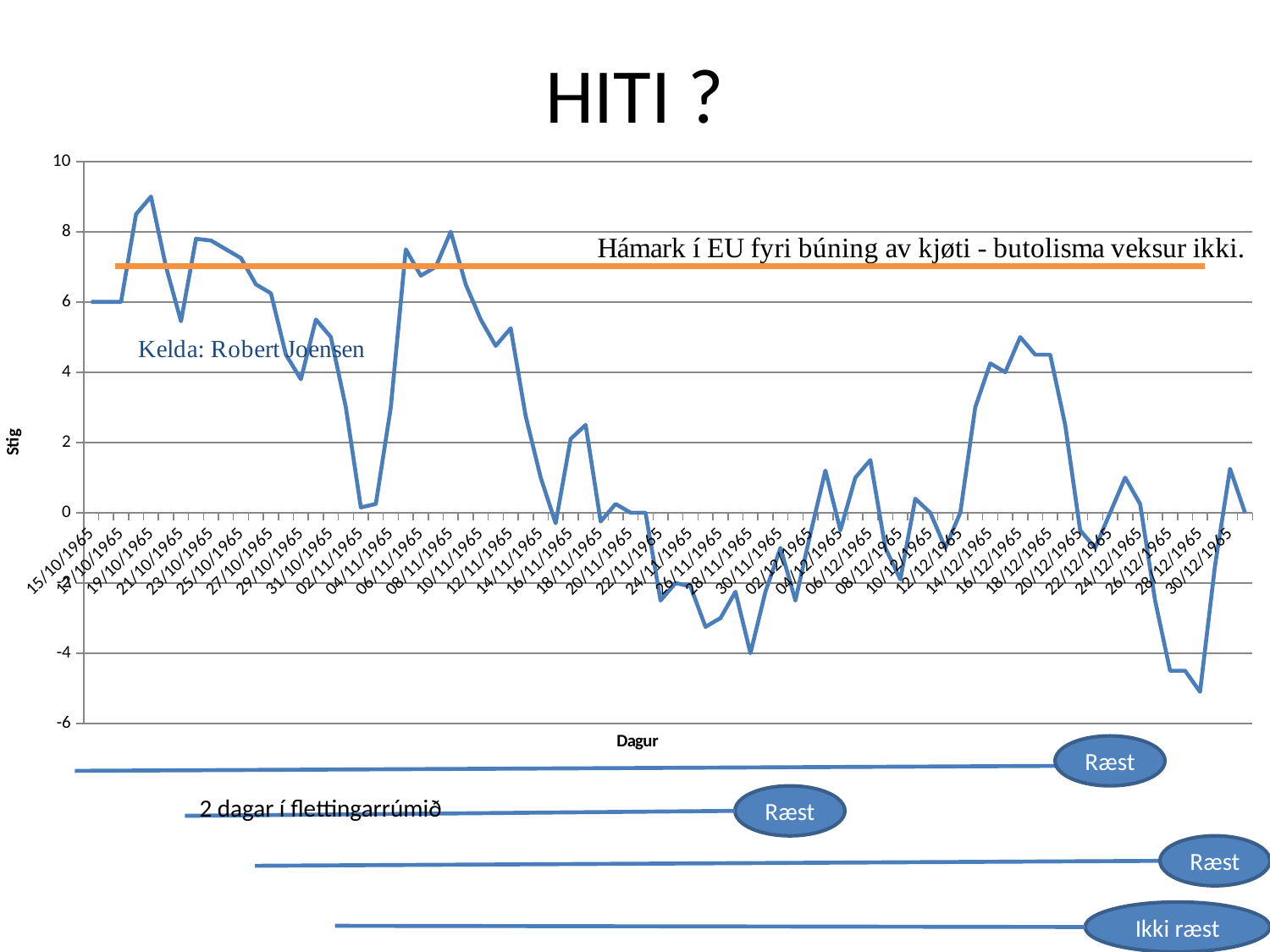
What kind of chart is shown on the slide? line chart Do the values generally rise or fall from 15/10/1965 to the end of December 1965? fall Is the value around 28/11/1965 greater or less than -2? less Is the highest value on the line greater or less than 8? greater Is the lowest value on the line greater or less than -4? less What is the label on the vertical axis of the chart? Stig In which month does the line reach its highest point? October 1965 Which is larger, the value at 15/10/1965 or the value at 30/12/1965? 15/10/1965 What is the title of the chart? HITI ?